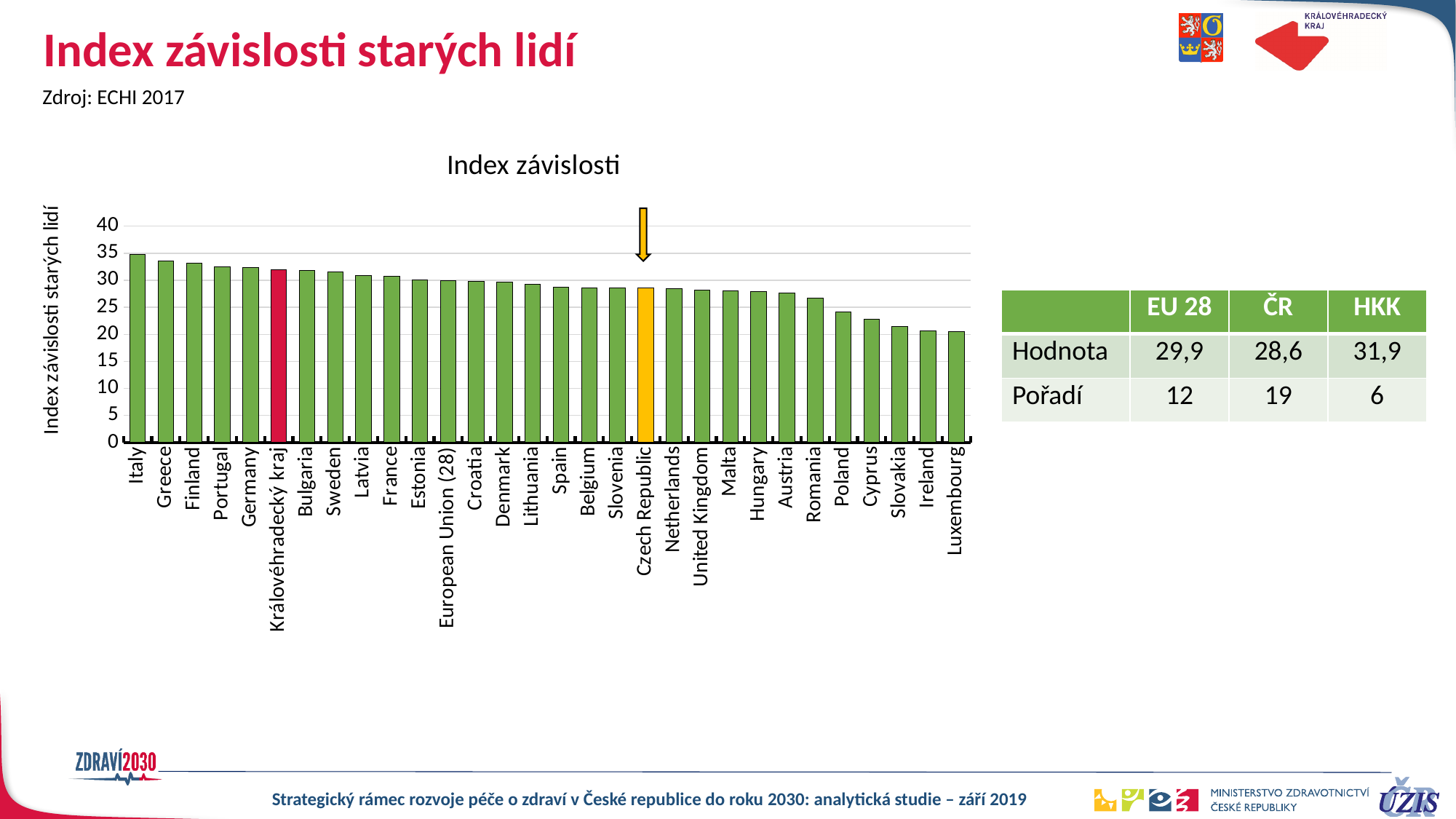
What is the title of the chart? Index závislosti According to the table next to the chart, what is the value (Hodnota) for Královéhradecký kraj (HKK)? 31,9 What colour is the bar for Czech Republic in the chart? yellow What type of chart is shown on the slide? bar chart Is the value for Cyprus greater or less than 25? less Do the bar values rise or fall from left to right along the x axis? fall Is the value for Italy greater or less than 30? greater Which has the larger value, Greece or Poland? Greece How many bars (categories) are plotted in the chart? 30 Which category has the highest value in the chart? Italy According to the table next to the chart, what is the value (Hodnota) for the Czech Republic (ČR)? 28,6 Which category has the lowest value in the chart? Luxembourg